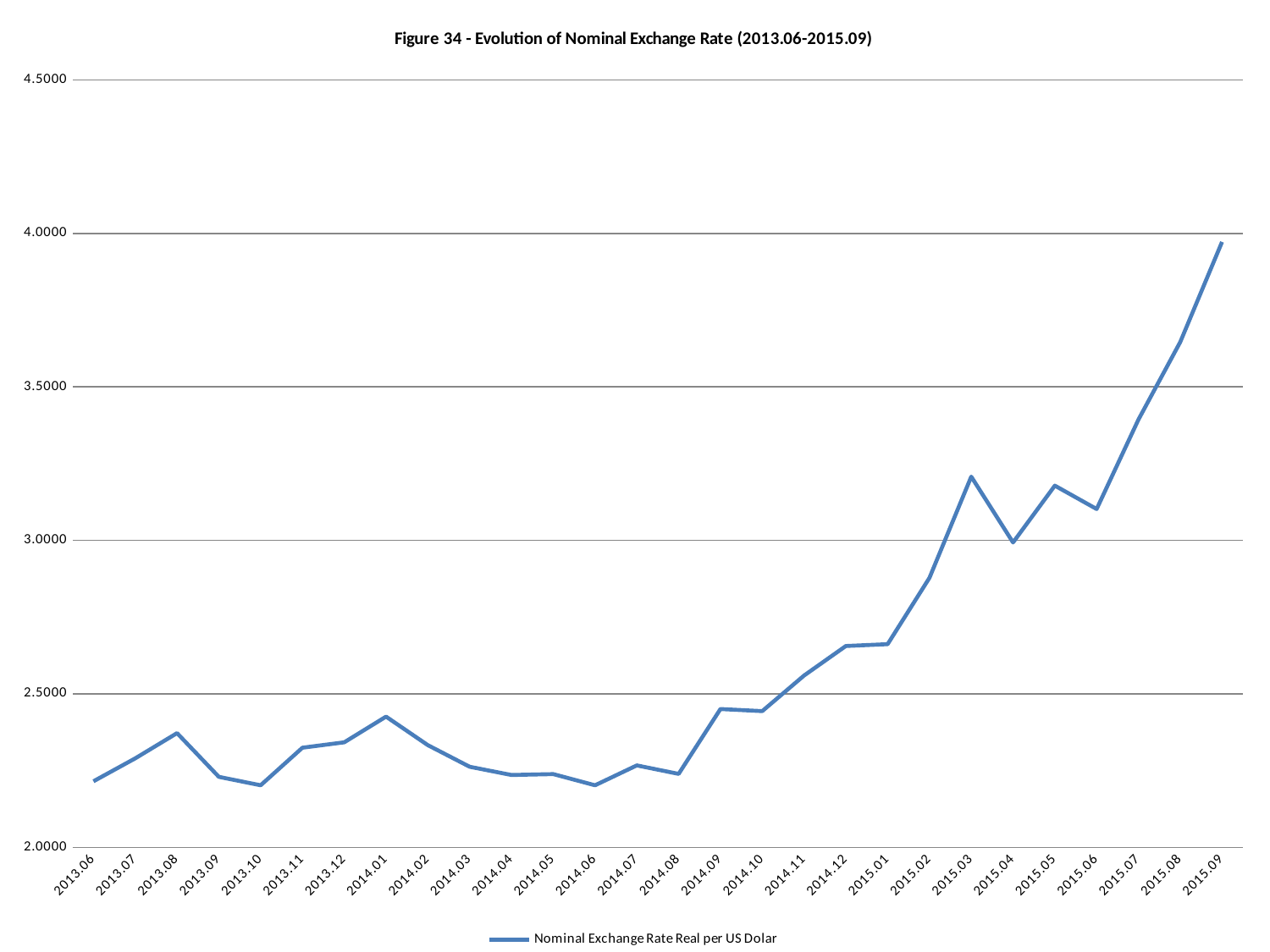
What is the title of the chart? Figure 34 - Evolution of Nominal Exchange Rate (2013.06-2015.09) What type of chart is shown on the slide? line chart In which month is the nominal exchange rate highest? 2015.09 Is the value for 2015.09 greater or less than 3.5000? greater Is the value for 2013.06 greater or less than 2.5000? less Does the nominal exchange rate generally rise or fall from 2013.06 to 2015.09? rise What is the name of the series shown in the legend? Nominal Exchange Rate Real per US Dolar Which is larger, the value for 2015.03 or the value for 2015.04? 2015.03 How many monthly data points are plotted on the chart? 28 How many series does the legend list? 1 Is the value for 2014.12 greater or less than 2.5000? greater